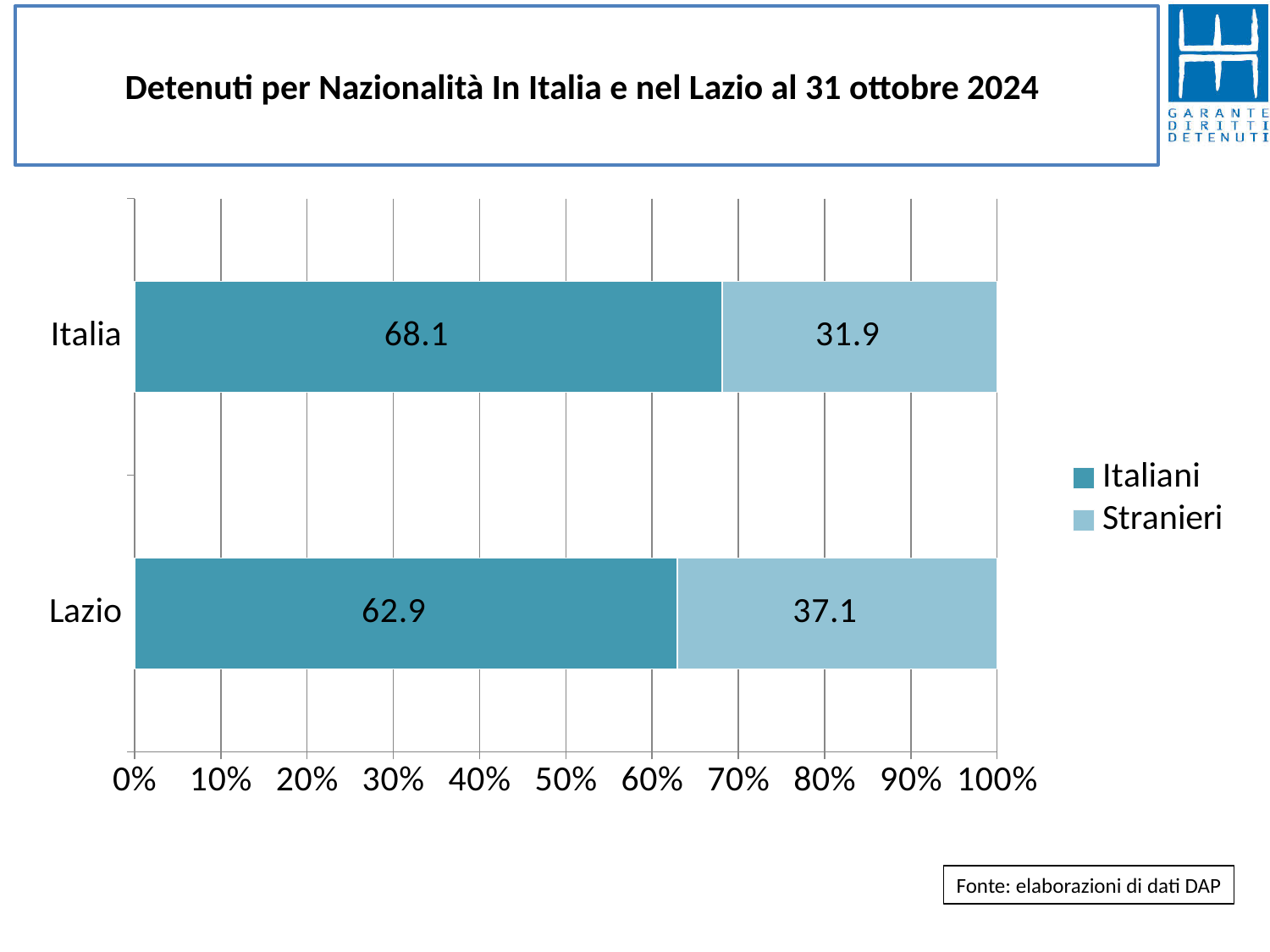
What is the value for Stranieri in Lazio? 37.1 What is the value for Italiani in Lazio? 62.9 Which category has the lower Stranieri value? Italia How many series does the legend list? 2 Which category has the higher Italiani value, Italia or Lazio? Italia What is the value for Stranieri in Italia? 31.9 What is the difference between the Stranieri values for Lazio and Italia? 5.2 Is the Italiani value for Lazio greater or less than 60%? greater How many categories are shown on the chart? 2 What is the difference between the Italiani values for Italia and Lazio? 5.2 What kind of chart is shown on the slide? Stacked bar chart What is the value for Italiani in Italia? 68.1